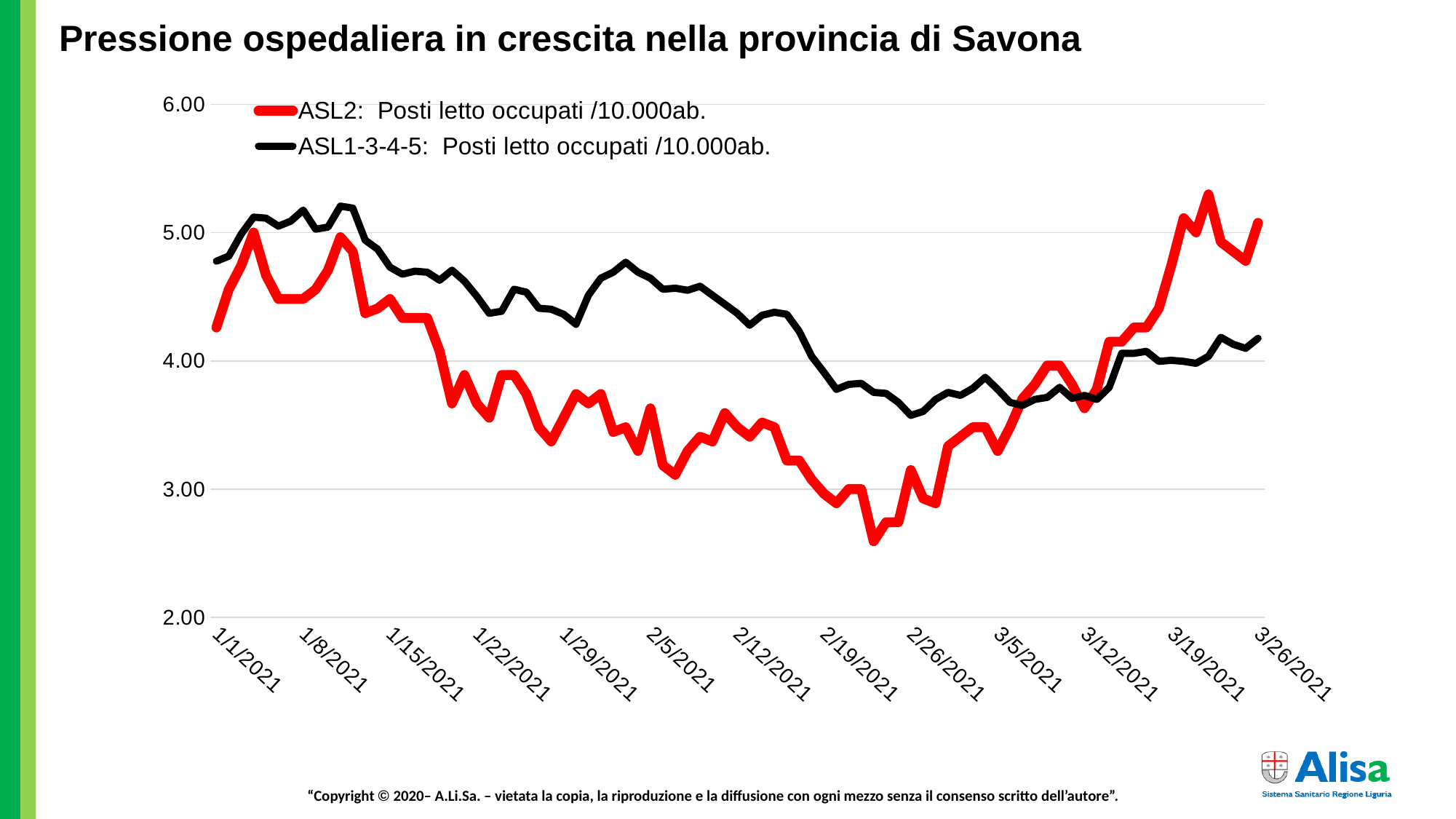
What is the title of the slide's chart? Pressione ospedaliera in crescita nella provincia di Savona Is the value for ASL1-3-4-5 on 2/26/2021 greater or less than 4.00? less Is the value for ASL1-3-4-5 on 1/8/2021 greater or less than 5.00? greater Does the ASL1-3-4-5 series rise or fall between 1/8/2021 and 2/19/2021? fall On 3/19/2021, which series has the higher value, ASL2 or ASL1-3-4-5? ASL2 How many series does the legend list? 2 Is the value for ASL2 on 3/19/2021 greater or less than 5.00? less On 2/5/2021, which series has the higher value, ASL2 or ASL1-3-4-5? ASL1-3-4-5 Does the ASL2 series rise or fall between 2/19/2021 and 3/26/2021? rise What kind of chart is shown on the slide? line chart Which colour is used for the ASL2 series? red